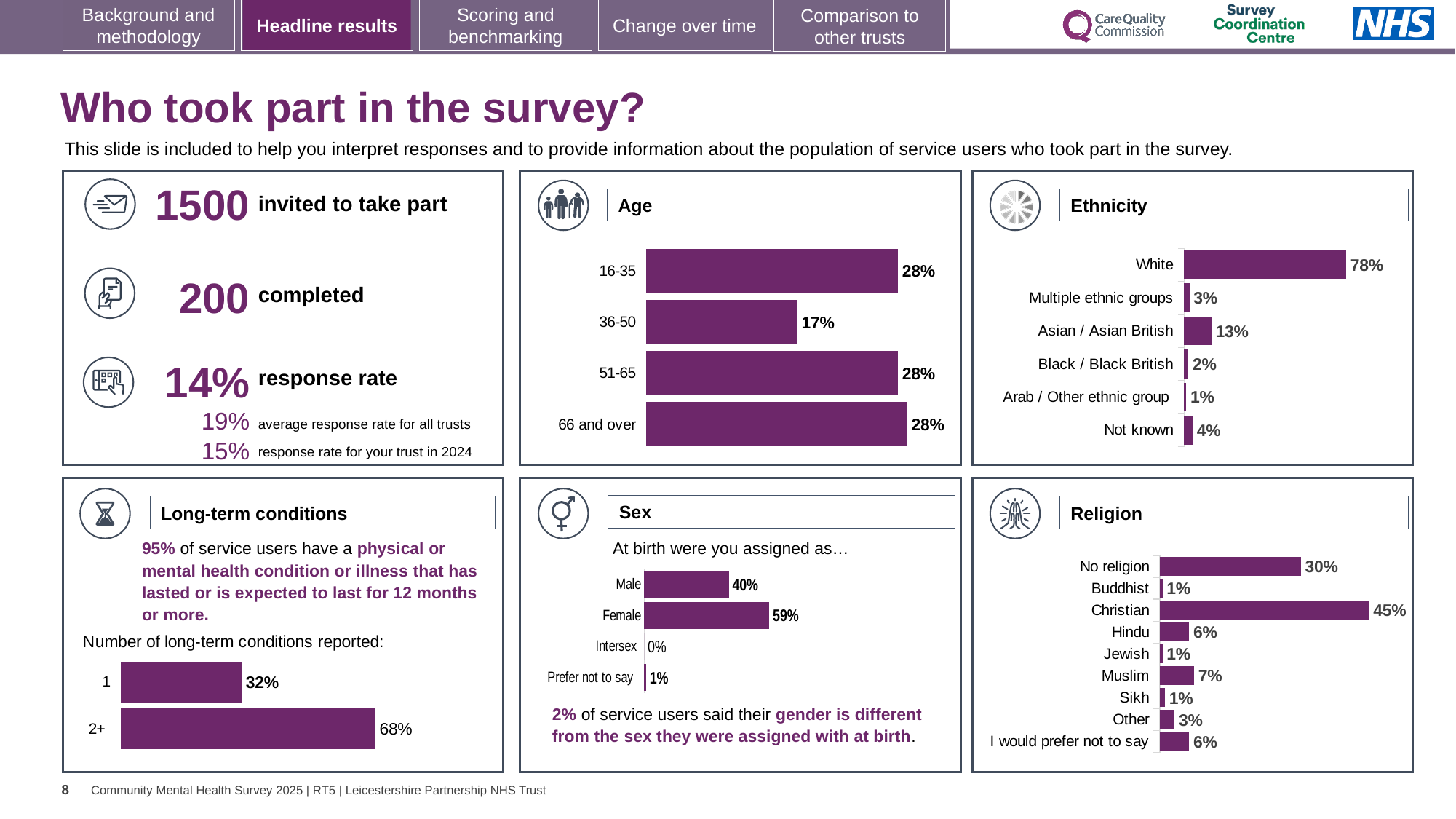
In the Religion chart, what is the value for Muslim? 7% In the Religion chart, which category has the highest value? Christian In the Ethnicity chart, what is the value for Asian / Asian British? 13% In the Ethnicity chart, which category has the highest value? White In the Long-term conditions chart, what percentage reported 2+ conditions? 68% In the Religion chart, how many categories are shown? 9 In the Sex chart, which is larger, Male or Female? Female In the Age chart, which age group has the lowest value? 36-50 In the Age chart, what percentage of respondents were aged 36-50? 17% What type of chart is used in the Ethnicity panel? Bar chart In the Sex chart, what is the difference between Female and Male? 19% In the Ethnicity chart, what is the difference between White and Asian / Asian British? 65%